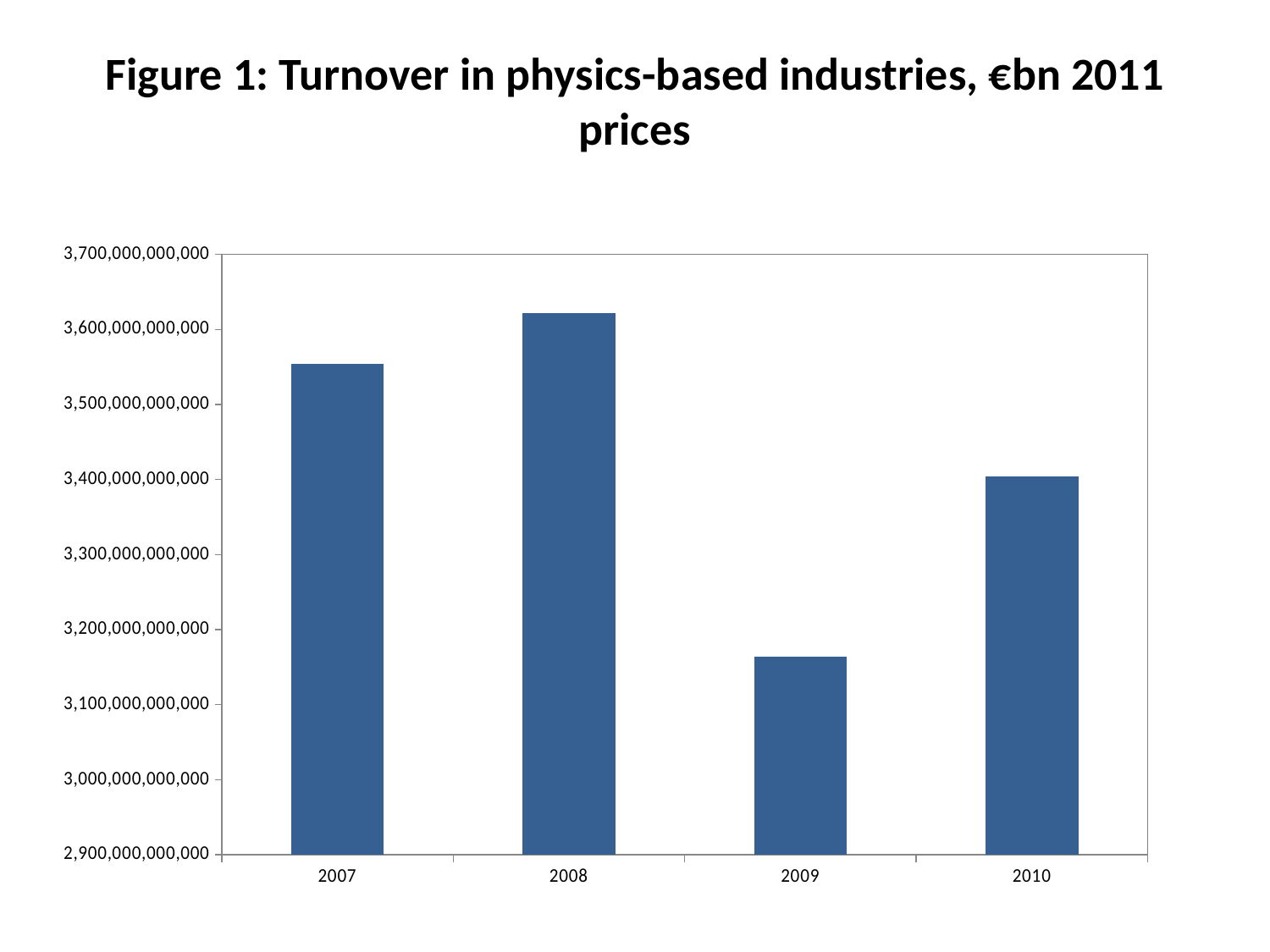
Is the turnover for 2007 greater or less than 3,500,000,000,000? greater How many years are shown on the x axis of the chart? 4 Is the turnover for 2009 greater or less than 3,200,000,000,000? less Which year has the larger turnover, 2007 or 2010? 2007 Which year has the lowest turnover in the chart? 2009 Is the turnover for 2010 greater or less than 3,500,000,000,000? less Which year has the larger turnover, 2009 or 2010? 2010 What kind of chart is shown on the slide? bar chart Does the turnover rise or fall from 2008 to 2009? fall Which year has the highest turnover in the chart? 2008 What is the title of the chart on the slide? Figure 1: Turnover in physics-based industries, €bn 2011 prices